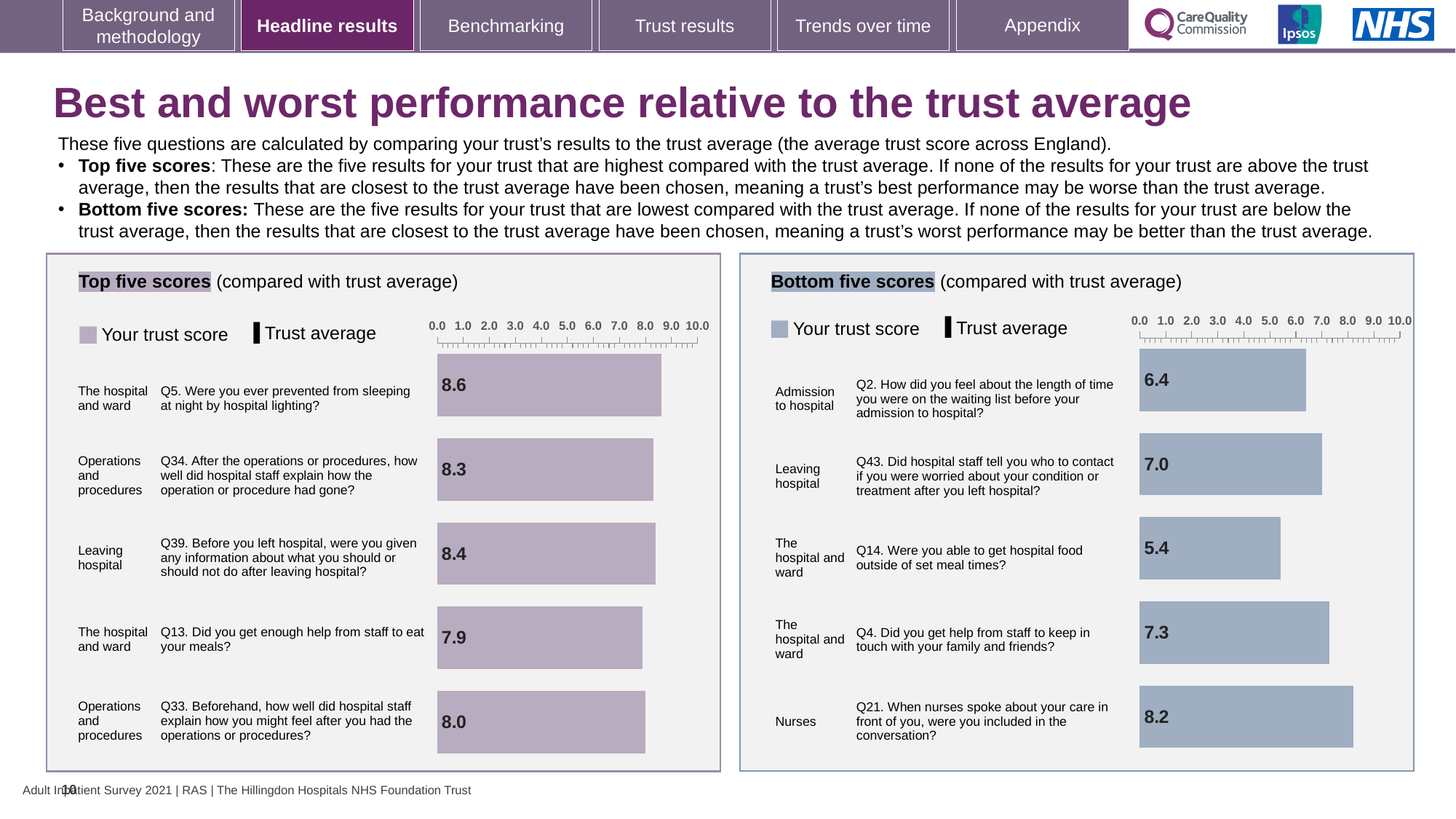
In the 'Bottom five scores' chart, which has the larger score: Q2 or Q43? Q43 In the 'Bottom five scores' chart, what is the difference between the scores for Q21 and Q14? 2.8 In the 'Top five scores' chart, what is the trust score for Q5 (Were you ever prevented from sleeping at night by hospital lighting?)? 8.6 In the 'Bottom five scores' chart, what is the trust score for Q14 (Were you able to get hospital food outside of set meal times?)? 5.4 How many entries does the legend of the 'Top five scores' chart list? 2 In the 'Top five scores' chart, what is the difference between the scores for Q5 and Q13? 0.7 In the 'Bottom five scores' chart, which question has the lowest trust score? Q14 In the 'Top five scores' chart, what is the trust score for Q13 (Did you get enough help from staff to eat your meals?)? 7.9 In the 'Top five scores' chart, which question has the highest trust score? Q5 How many questions are plotted in the 'Bottom five scores' chart? 5 In the 'Bottom five scores' chart, what is the trust score for Q21 (When nurses spoke about your care in front of you, were you included in the conversation?)? 8.2 What type of chart is the 'Top five scores' chart? Bar chart